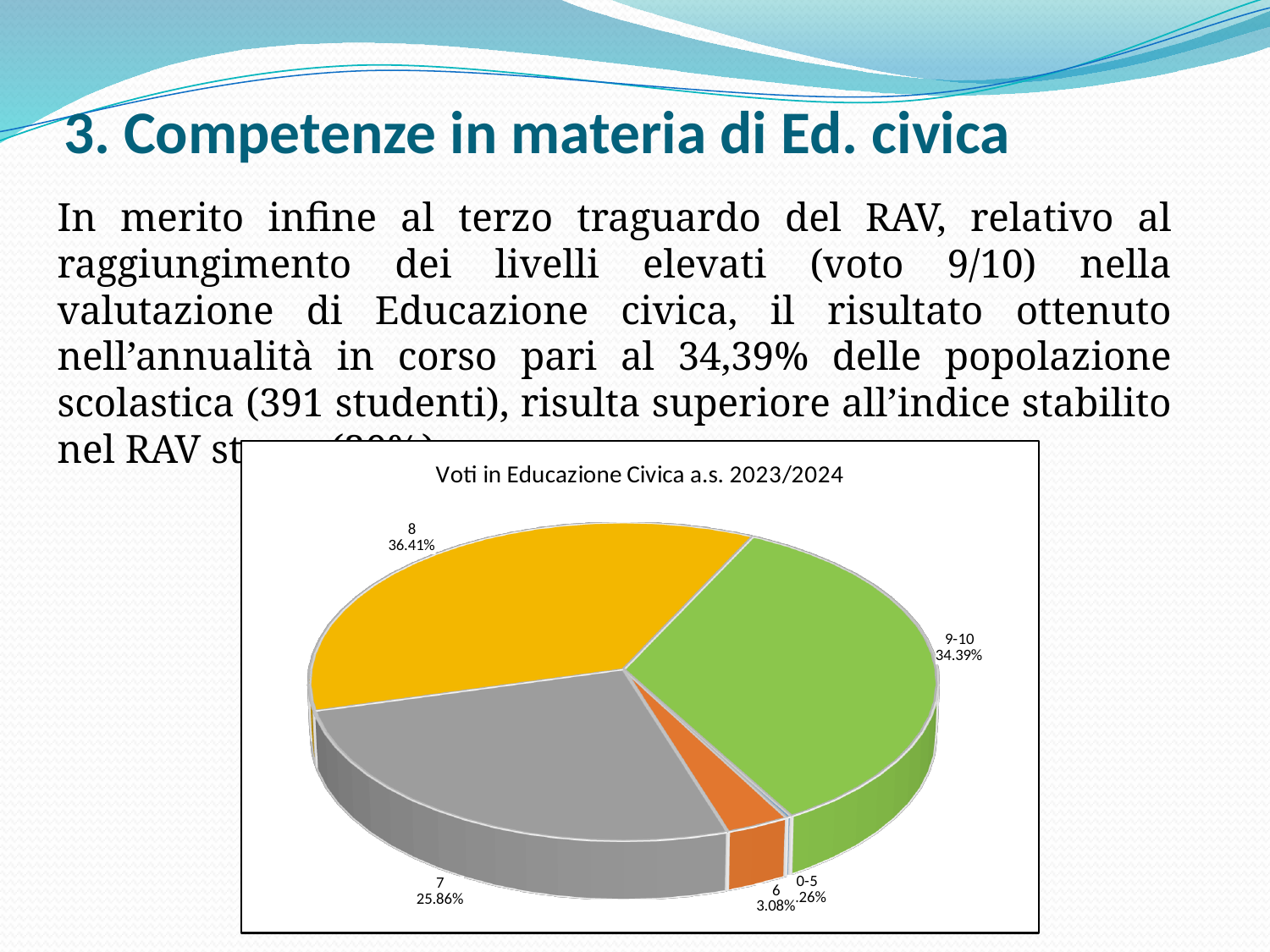
What share of the pie does the slice for grade 8 represent? 36.41% What share of the pie does the slice for grade 6 represent? 3.08% Which grade category has the largest slice of the pie? 8 What share of the pie does the slice for grades 9-10 represent? 34.39% How many slices does the pie chart have? 5 What is the difference in percentage points between the slice for grade 8 and the slice for grades 9-10? 2.02% What kind of chart is shown on the slide? pie chart What share of the pie does the slice for grade 7 represent? 25.86% Which grade category has the smallest slice of the pie? 0-5 What is the title of the chart? Voti in Educazione Civica a.s. 2023/2024 Which slice is larger, grade 8 or grades 9-10? 8 What is the difference in percentage points between the slice for grades 9-10 and the slice for grade 7? 8.53%